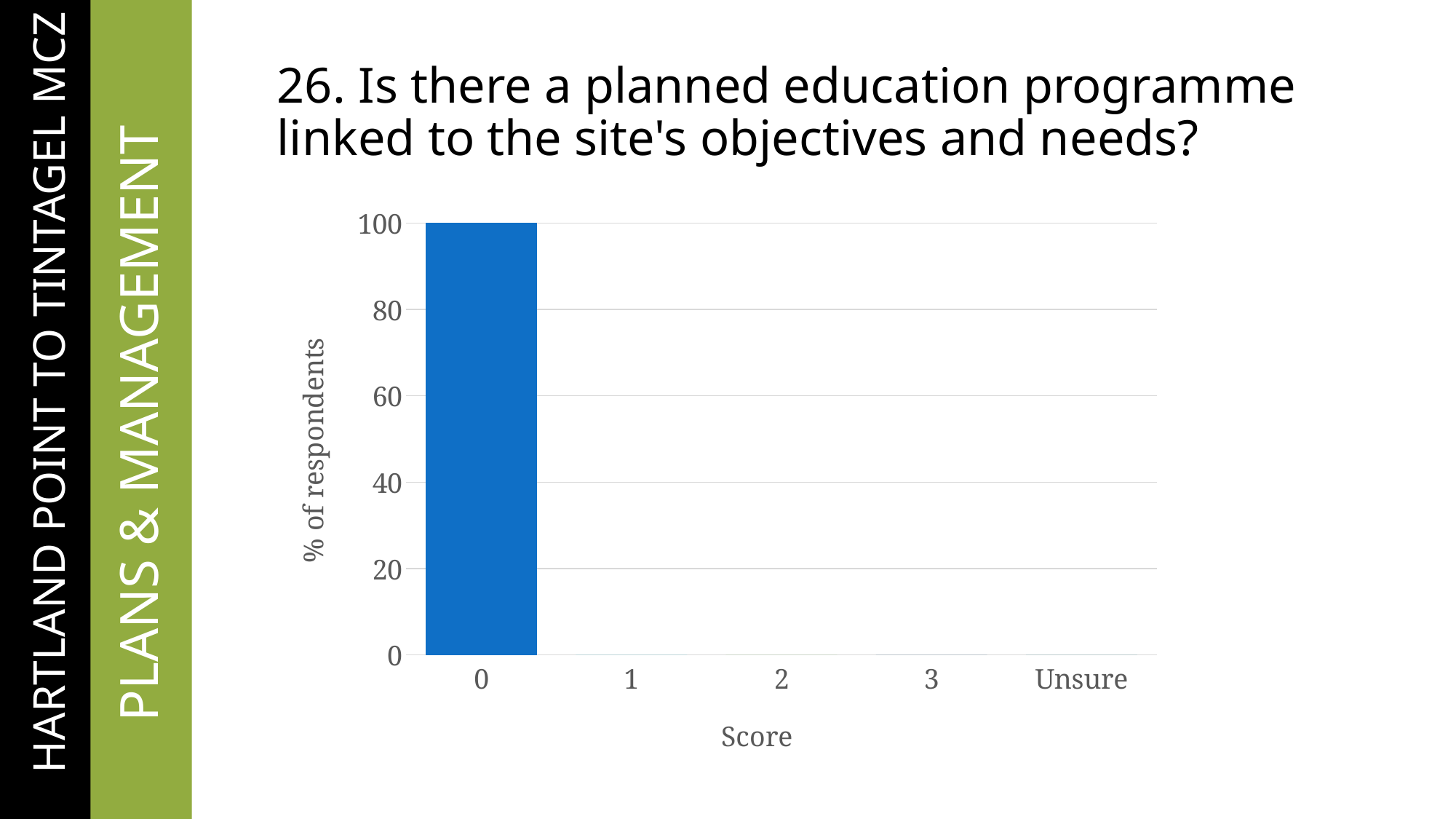
What is the value for score 1? 0 Which score category has the highest percentage of respondents? 0 What is the difference between the value for score 0 and the value for score 2? 100 What is the label of the x axis? Score Do the values rise or fall from score 0 to score 1? fall Which is larger, the value for score 0 or the value for score 3? score 0 What is the label of the y axis? % of respondents What type of chart is shown on the slide? bar chart How many categories are shown on the x axis? 5 What is the value for score 0? 100 Is the value for score 0 greater or less than 80? greater What is the value for the Unsure category? 0